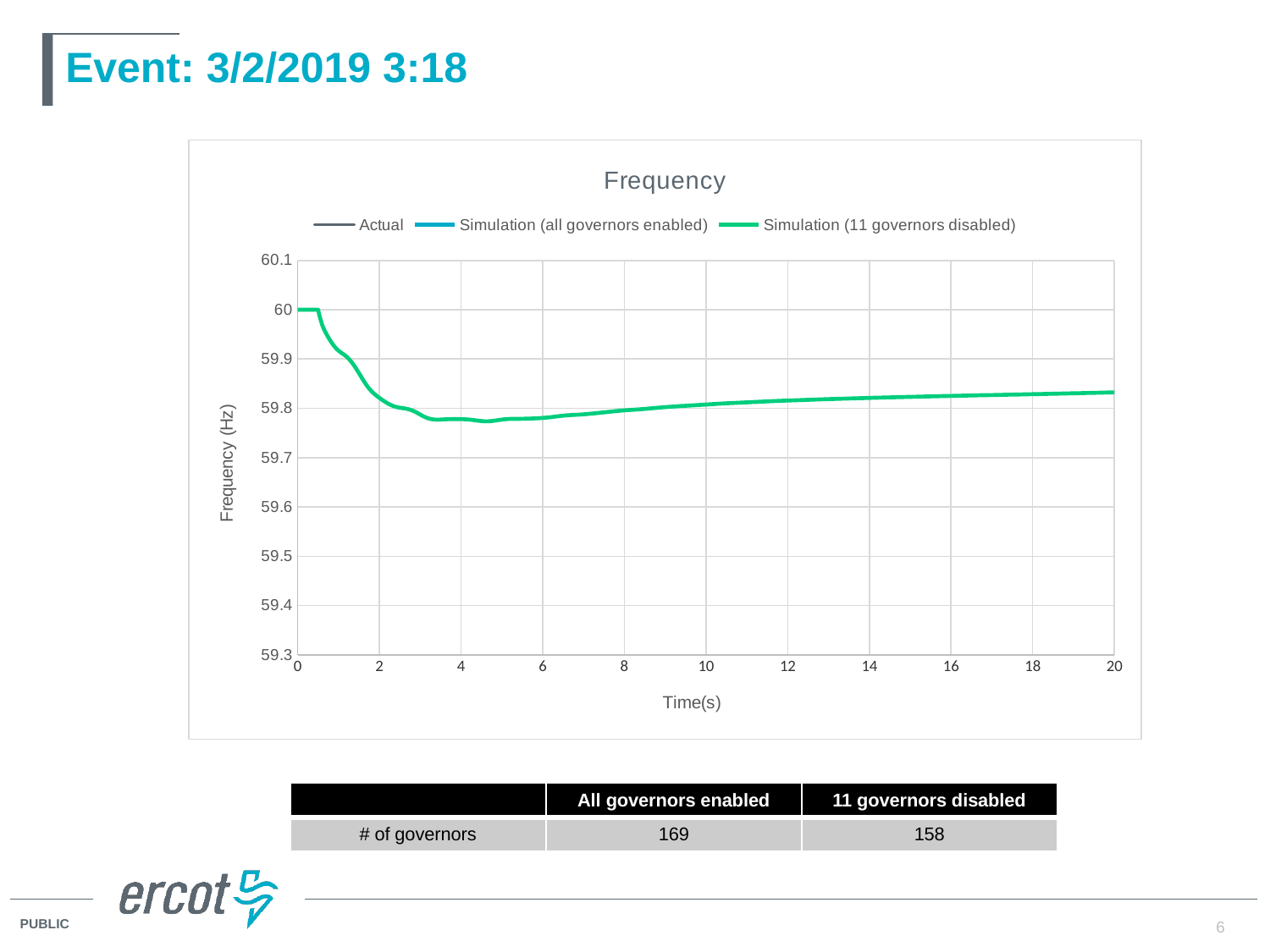
What is the highest value shown on the x axis (Time(s))? 20 How many series does the chart's legend list? 3 Is the plotted frequency at 20 seconds greater or less than 60? less What is the title of the chart? Frequency What kind of chart is shown on the slide? line chart Which is larger, the plotted frequency at 1 second or at 4 seconds? 1 second What is the label of the chart's y axis? Frequency (Hz) Is the plotted frequency at 10 seconds greater or less than 59.7? greater Does the plotted frequency rise or fall between 0 and 2 seconds? fall Is the plotted frequency at 4 seconds greater or less than 59.9? less Does the plotted frequency rise or fall between 6 and 20 seconds? rise